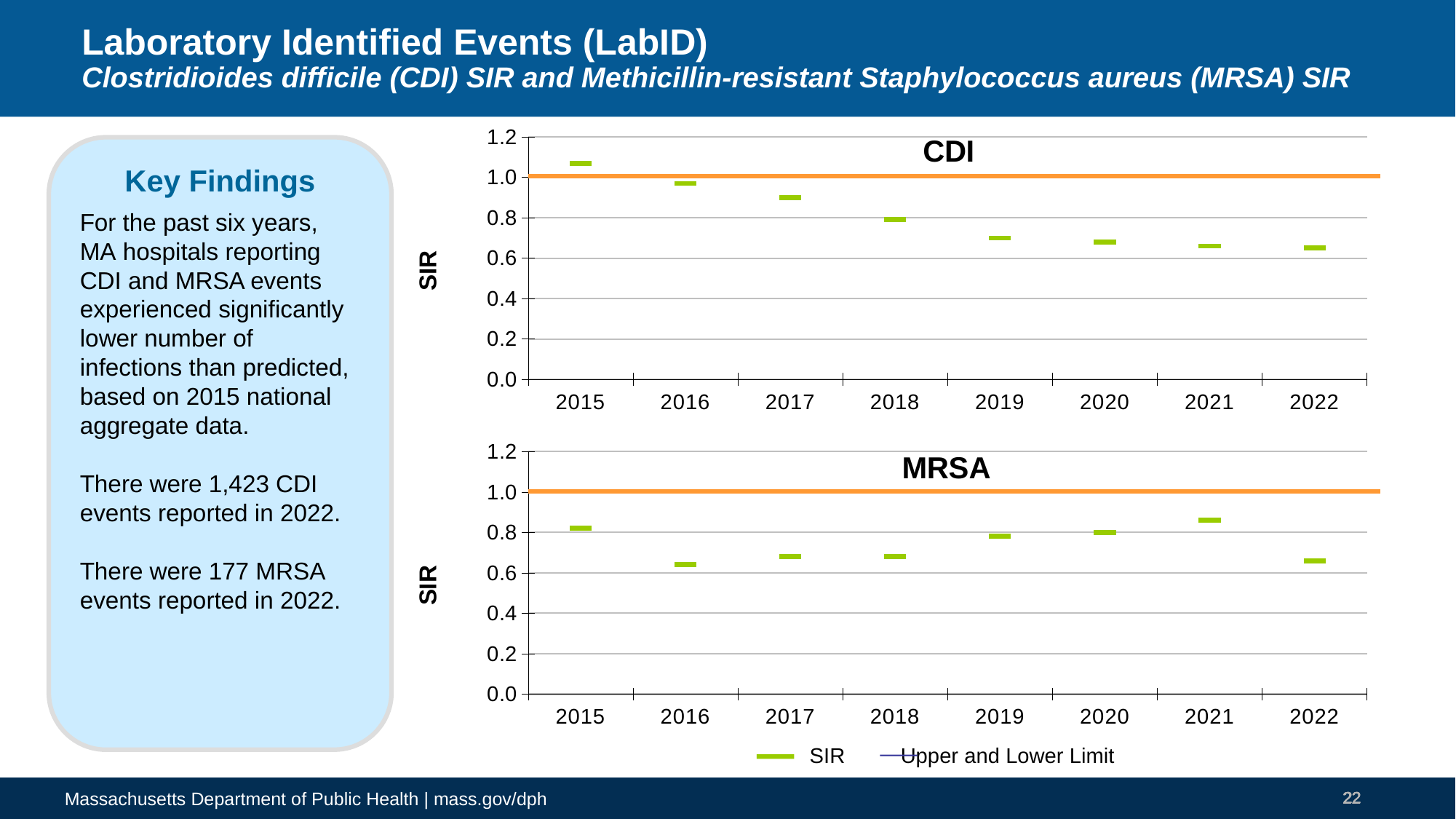
In the MRSA chart, is the SIR value for 2021 greater or less than 0.8? greater In the CDI chart, do the SIR values generally rise or fall from 2015 to 2022? fall In the MRSA chart, is the SIR value for 2016 greater or less than 0.8? less What is the label on the y axis of the CDI chart? SIR In the CDI chart, is the SIR value for 2017 greater or less than 0.8? greater In the MRSA chart, which year has the larger SIR value, 2021 or 2016? 2021 How many years are plotted on the x axis of the MRSA chart? 8 In the CDI chart, which year has the highest SIR value? 2015 How many series does the legend below the charts list? 2 In the CDI chart, which year has the larger SIR value, 2016 or 2019? 2016